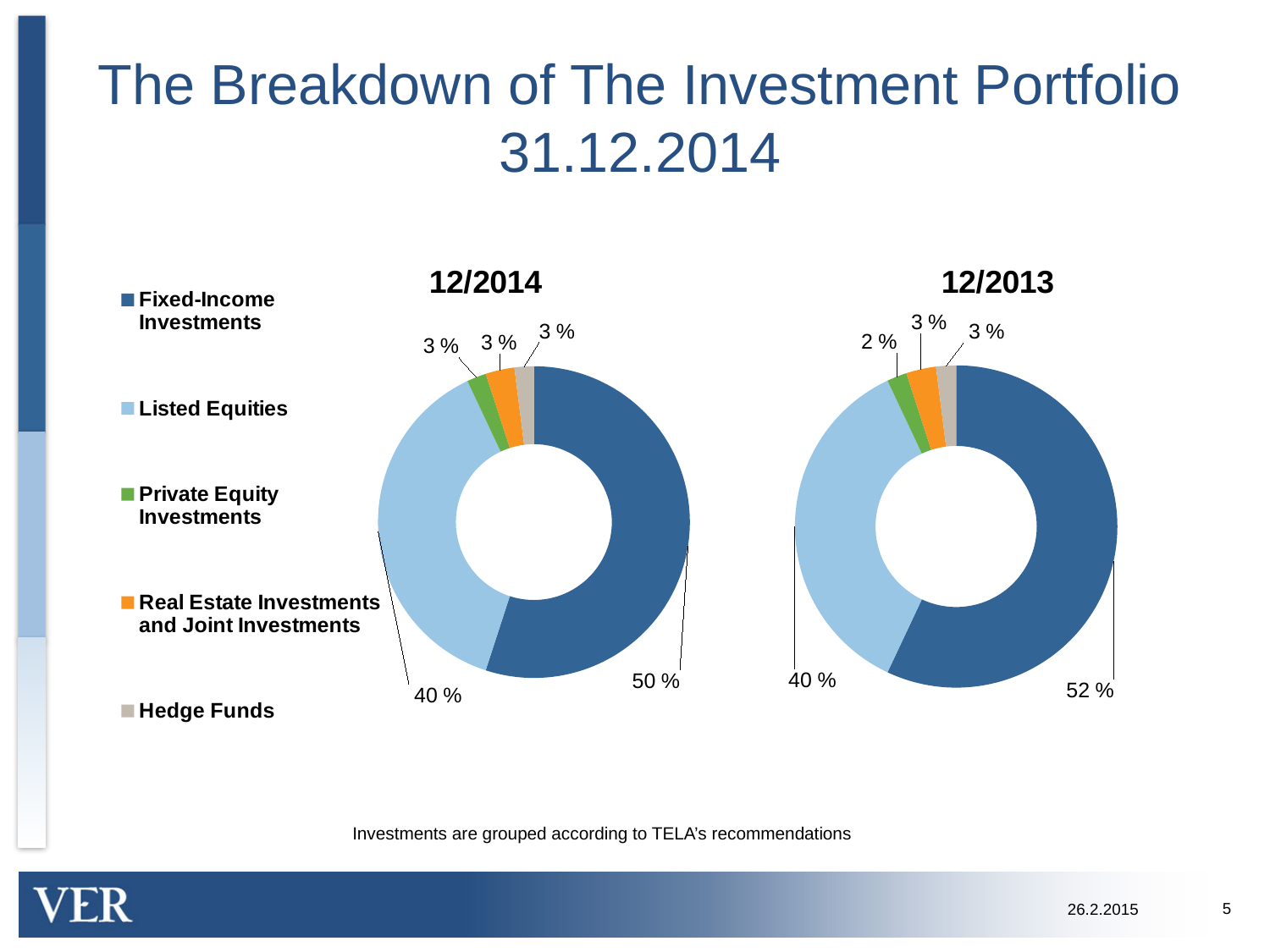
In the 12/2013 chart, which category has the smallest share? Private Equity Investments Which colour represents Real Estate Investments and Joint Investments in the charts? Orange In the 12/2014 chart, which category has the largest share? Fixed-Income Investments What kind of chart is the 12/2014 chart? Pie (doughnut) chart How many categories does the legend list for the charts? 5 In the 12/2014 chart, which is larger: Fixed-Income Investments or Listed Equities? Fixed-Income Investments In the 12/2013 chart, what share of the portfolio is Private Equity Investments? 2 % In the 12/2014 chart, what share of the portfolio is Listed Equities? 40 % In the 12/2013 chart, what share of the portfolio is Fixed-Income Investments? 52 % What is the difference between the Fixed-Income Investments share in the 12/2013 chart and in the 12/2014 chart? 2 % In the 12/2014 chart, what share of the portfolio is Hedge Funds? 3 % In the 12/2014 chart, what share of the portfolio is Fixed-Income Investments? 50 %